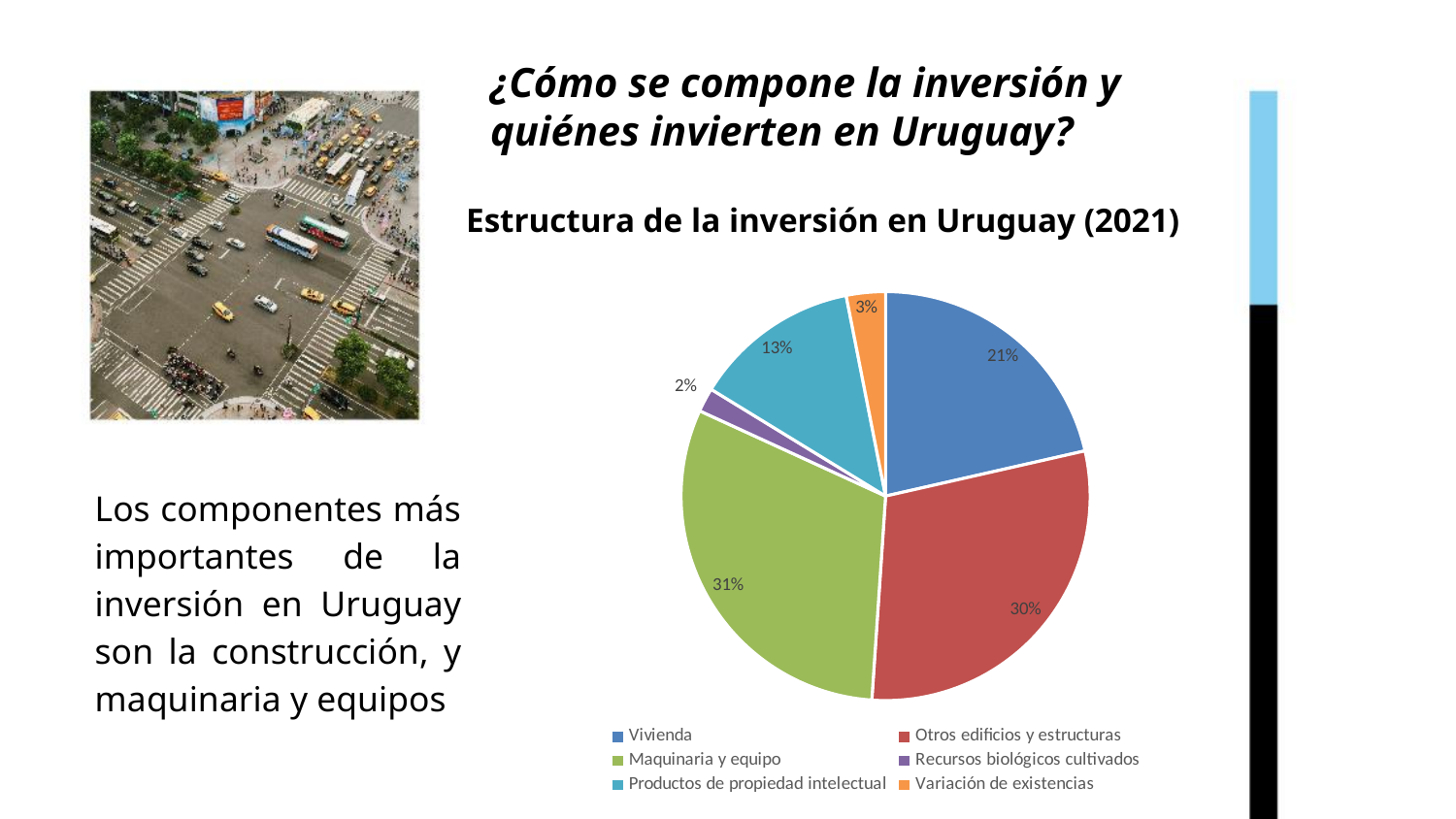
Which is larger, the share for Productos de propiedad intelectual or the share for Variación de existencias? Productos de propiedad intelectual Which category has the largest share of the pie? Maquinaria y equipo What colour is the slice for Otros edificios y estructuras? red What share of investment does Productos de propiedad intelectual represent? 13% What share of investment does Maquinaria y equipo represent? 31% What is the difference in percentage points between Otros edificios y estructuras and Vivienda? 9 How many categories does the pie chart show? 6 What type of chart is shown on the slide? pie chart What share of investment does Vivienda represent? 21% Which category has the smallest share of the pie? Recursos biológicos cultivados What is the title of the chart? Estructura de la inversión en Uruguay (2021) What share of investment does Variación de existencias represent? 3%